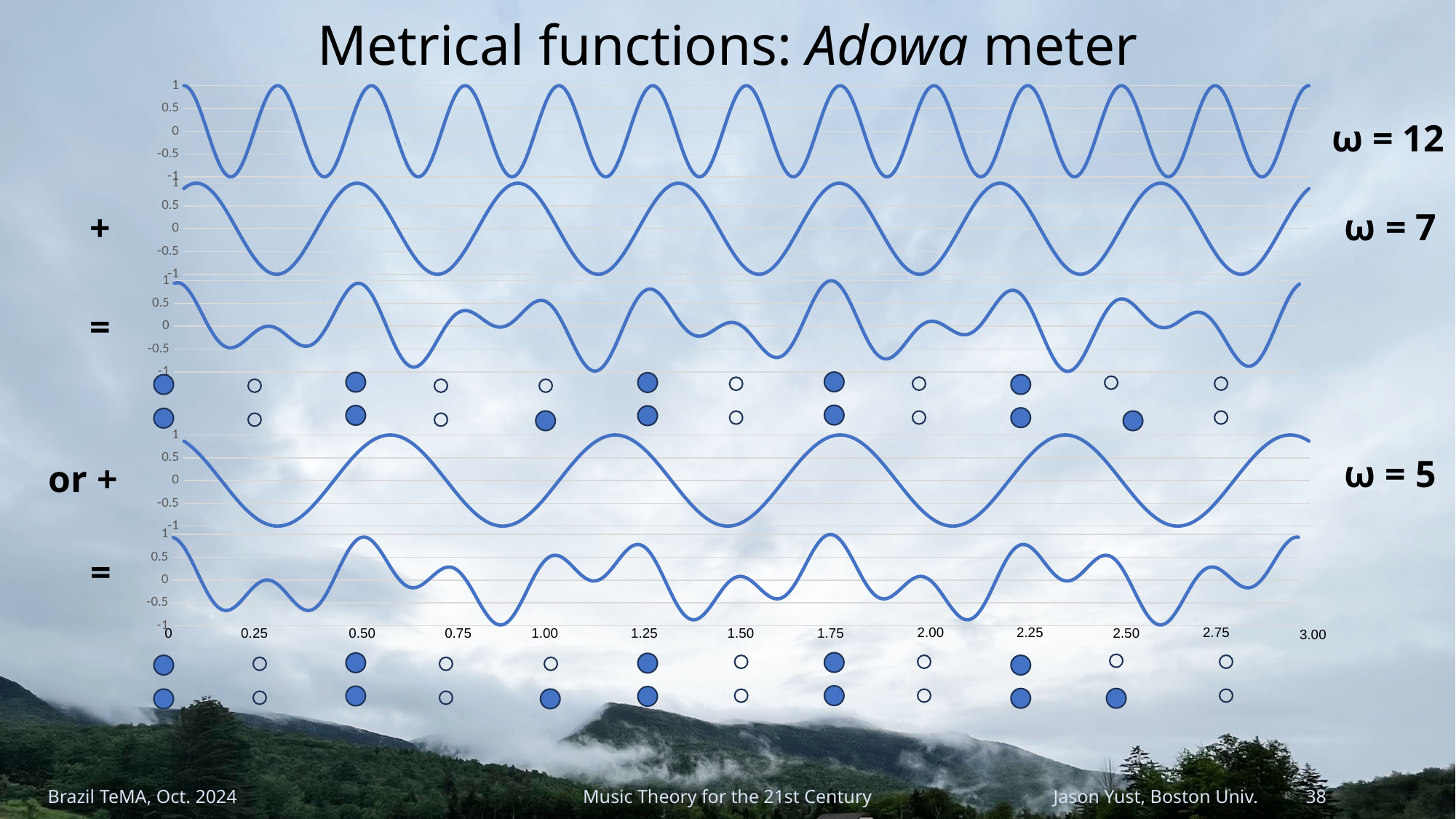
What is the highest value shown on the vertical axis of the ω = 12 chart? 1 In the ω = 5 chart, what is the value of the curve at x = 0? 1 How many line charts are stacked on the slide? 5 What is the lowest value shown on the vertical axis of the ω = 5 chart? -1 In the ω = 7 chart, is the value of the curve at x = 0.25 greater or less than 0? less In the ω = 5 chart, is the value of the curve at x = 0.25 greater or less than 0? less How many tick labels are printed on the horizontal axis at the bottom of the slide? 13 What kind of chart is used for the ω = 12 plot at the top of the slide? line chart What ω value is labelled next to the second chart from the top? ω = 7 In the ω = 12 chart, what is the value of the curve at x = 0? 1 Which of the three labelled sine-wave charts (ω = 12, ω = 7, ω = 5) has the most oscillations across the horizontal axis? ω = 12 What is the last tick label on the horizontal axis at the bottom of the slide? 3.00